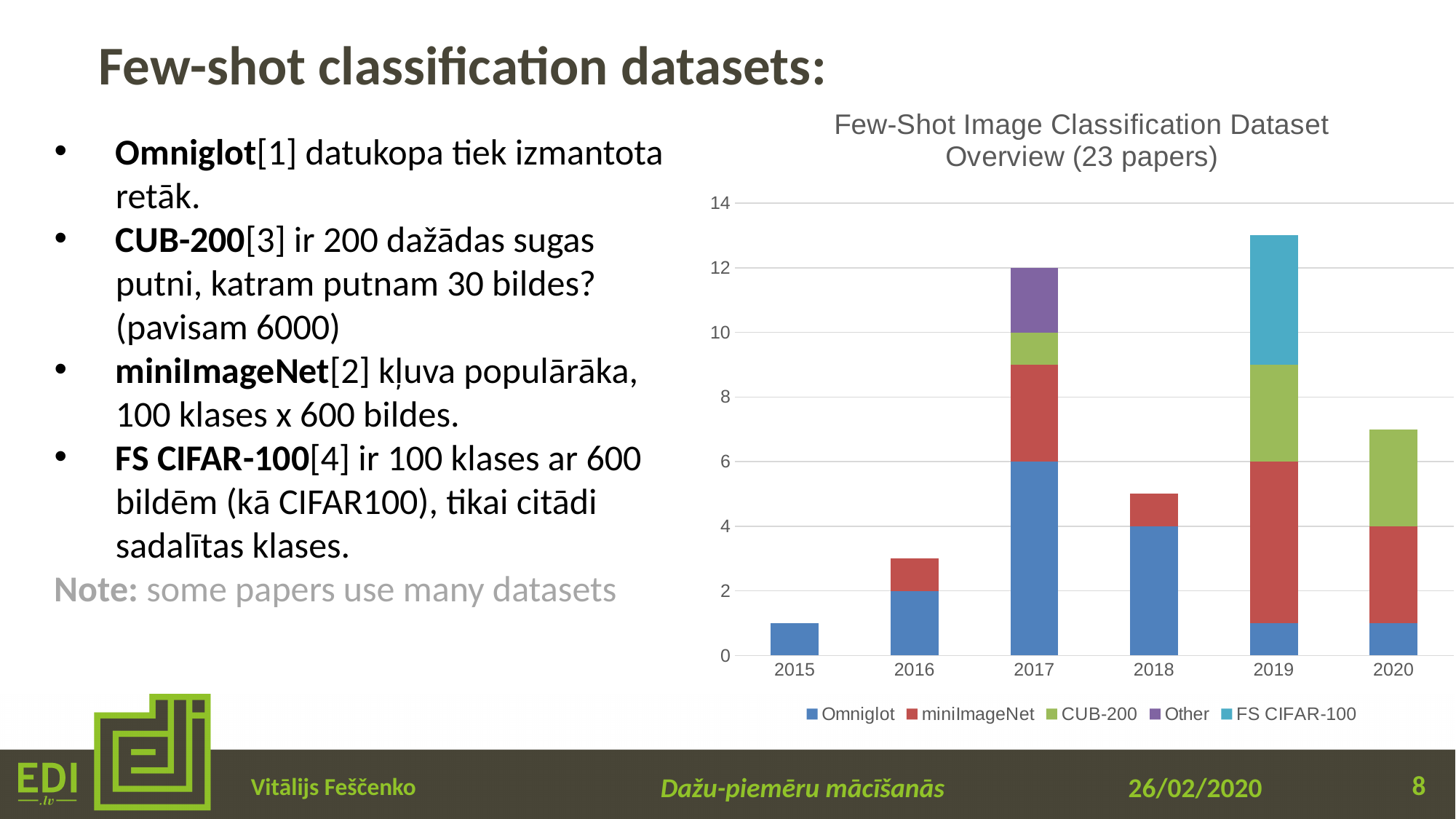
Which series appears only in the 2019 bar, according to the legend colours? FS CIFAR-100 Is the total for 2019 greater or less than 12? greater How many years are shown on the x axis of the chart? 6 Is the total for 2020 greater or less than 8? less What is the value for Omniglot in 2017? 6 What kind of chart is shown on the slide? Stacked bar chart How many series does the chart legend list? 5 Which year has the tallest stacked bar in the chart? 2019 What is the value for Omniglot in 2018? 4 Which year has a taller stacked bar, 2016 or 2018? 2018 Which year has the shortest stacked bar in the chart? 2015 What is the total height of the stacked bar for 2017? 12